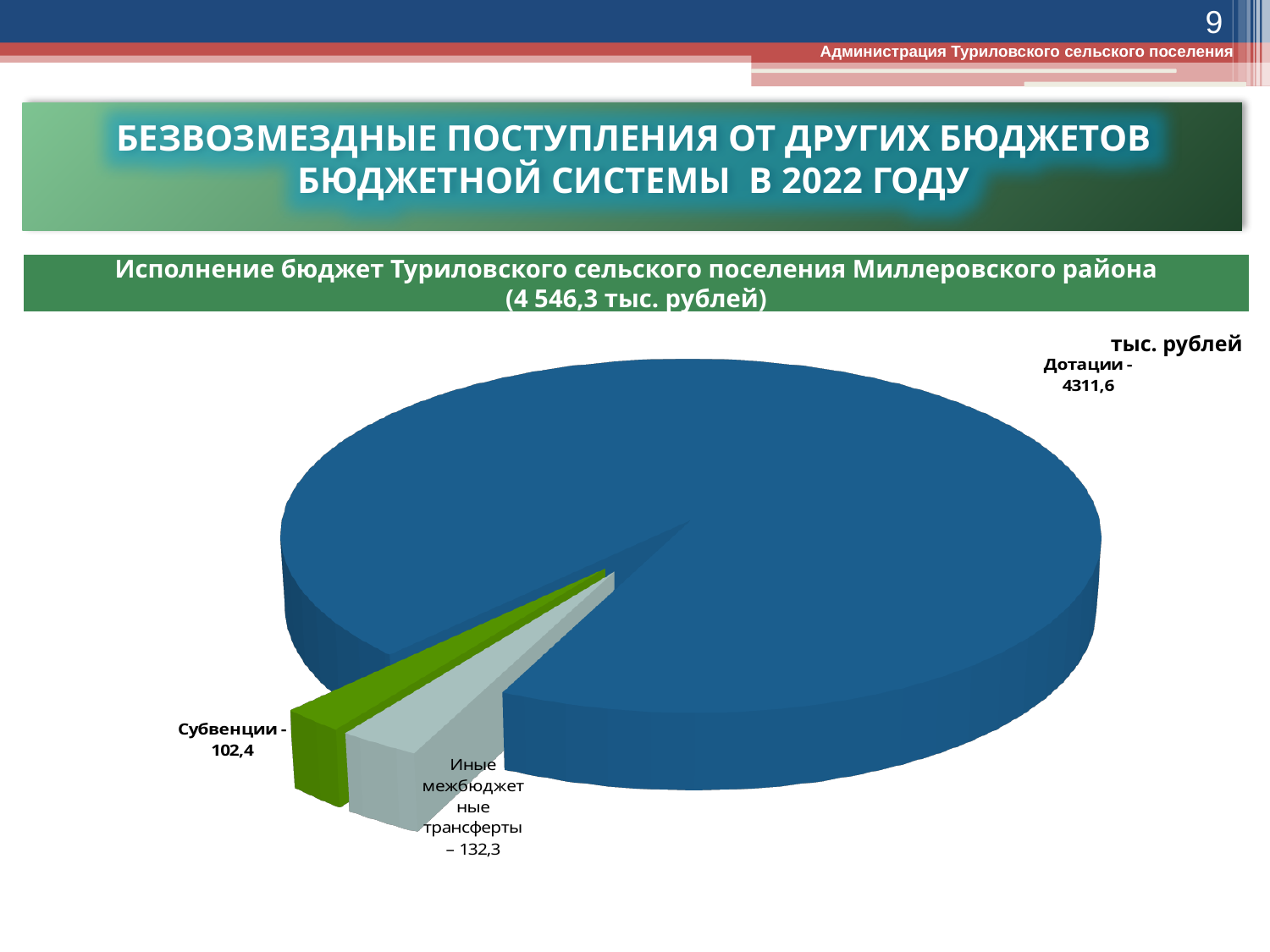
What is the value for Иные межбюджетные трансферты on the pie chart? 132,3 In what units are the values on the pie chart given? тыс. рублей What kind of chart is shown on the slide? Pie chart Which is larger, the value for Иные межбюджетные трансферты or the value for Субвенции? Иные межбюджетные трансферты Which category has the largest slice of the pie chart? Дотации Which category has the smallest slice of the pie chart? Субвенции What is the difference between the values for Иные межбюджетные трансферты and Субвенции? 29,9 What is the value for Субвенции on the pie chart? 102,4 What is the value for Дотации on the pie chart? 4311,6 How many slices does the pie chart have? 3 What is the difference between the values for Дотации and Иные межбюджетные трансферты? 4179,3 What is the total of all slices in the pie chart, as stated on the slide? 4 546,3 тыс. рублей